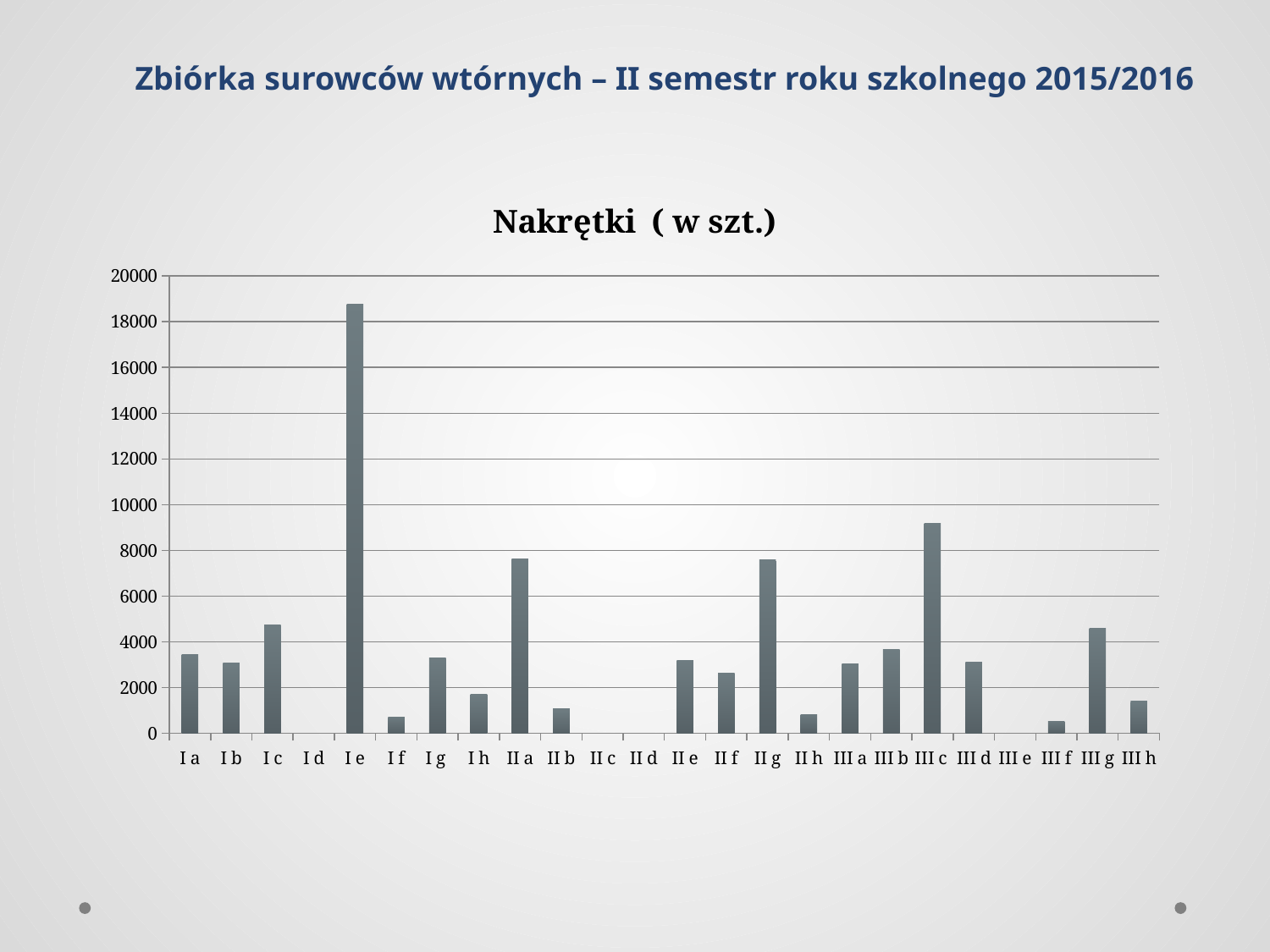
Is the value for II a greater or less than 6000? greater How many classes (categories) are shown on the x axis? 24 Which is larger, the value for III g or the value for III h? III g Which is larger, the value for I e or the value for III c? I e Is the value for I f greater or less than 2000? less Which is larger, the value for III c or the value for II g? III c What kind of chart is shown on the slide? bar chart Is the value for I c greater or less than 4000? greater What is the title of the chart? Nakrętki ( w szt.) Which class has the highest value in the chart? I e